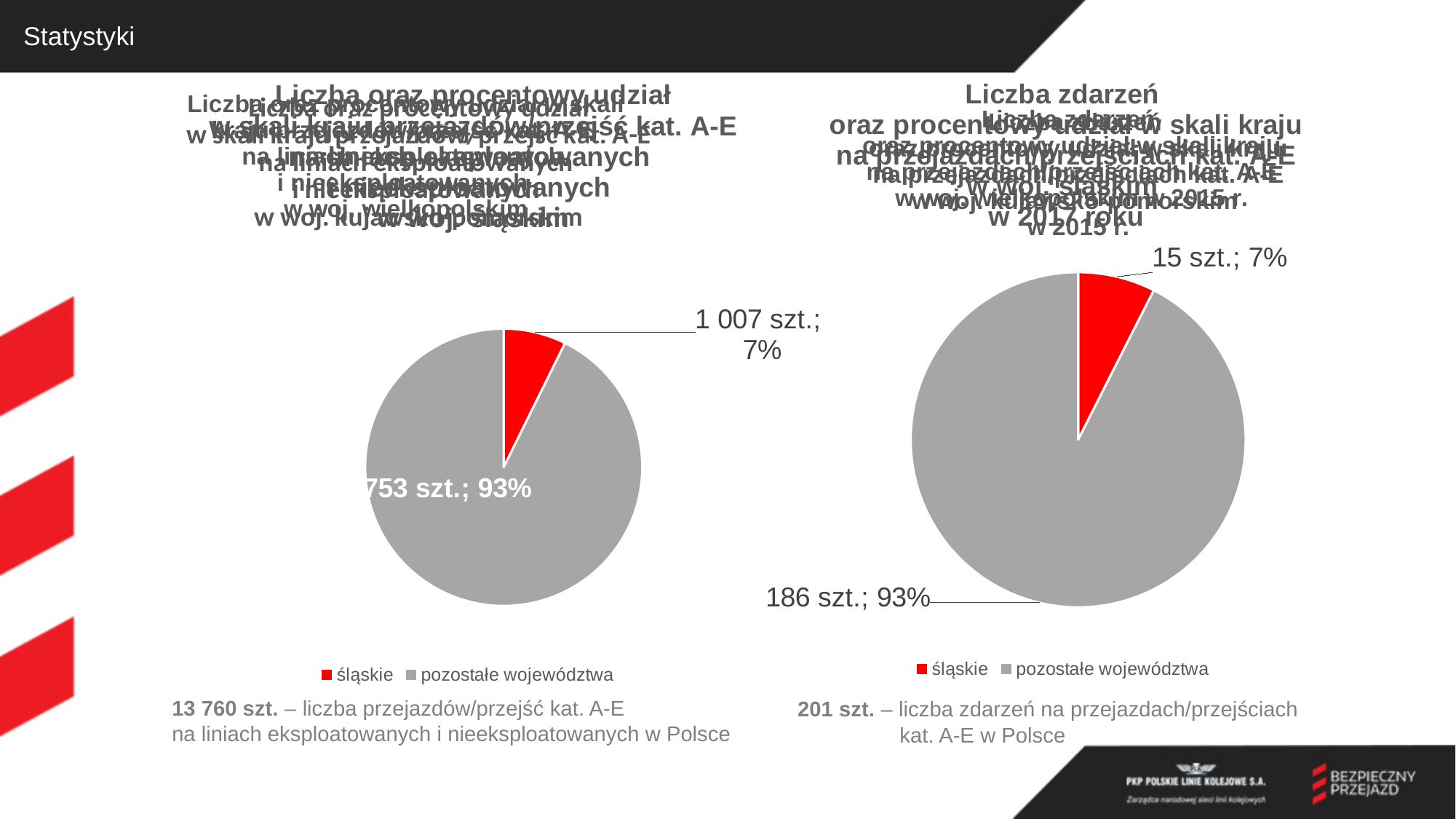
In the left pie chart, what share of the pie does śląskie represent? 7% In the right pie chart, what is the total of the two slices? 201 szt. In the left pie chart, which slice is larger: śląskie or pozostałe województwa? pozostałe województwa In the right pie chart, which colour represents śląskie? red In the right pie chart, what value is shown for pozostałe województwa? 186 szt. How many entries does the legend of the left pie chart list? 2 In the right pie chart, what value is shown for śląskie? 15 szt. In the left pie chart, what value is shown for śląskie? 1 007 szt. In the right pie chart, what share of the pie does śląskie represent? 7% What kind of chart is the left chart on the slide? pie chart In the left pie chart, what share of the pie does pozostałe województwa represent? 93% In the right pie chart, what is the difference between the values for pozostałe województwa and śląskie? 171 szt.